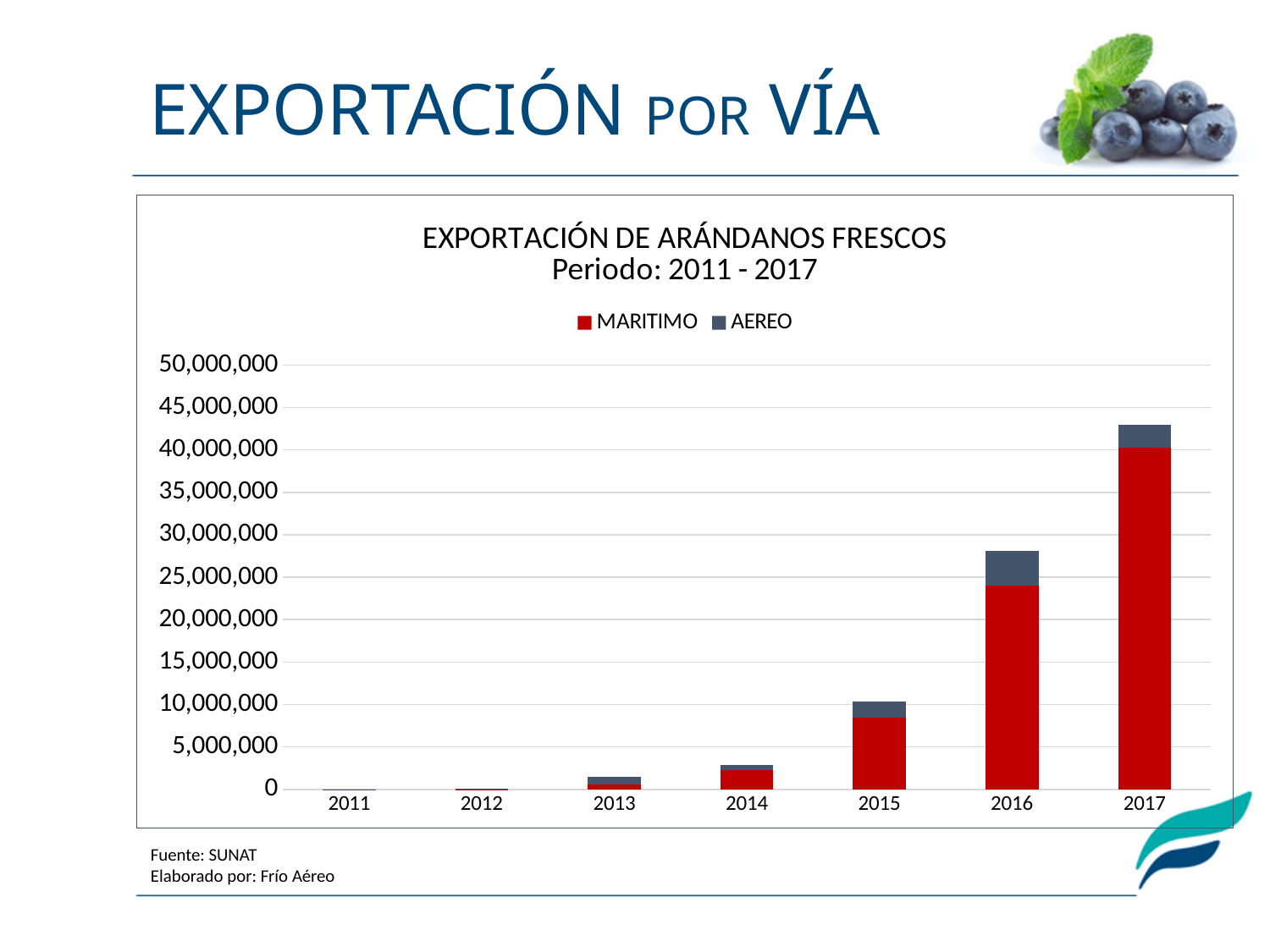
How many years are shown on the x axis of the chart? 7 In 2017, which series is larger, MARITIMO or AEREO? MARITIMO Which year has the lowest total export bar? 2011 Is the total stacked bar for 2017 greater or less than 40,000,000? greater Which colour represents the AEREO series in the chart? Gray Is the MARITIMO value for 2015 greater or less than 10,000,000? less Do the total export values rise or fall from 2011 to 2017? Rise Which year has the highest total export bar? 2017 Is the total stacked bar for 2016 greater or less than 30,000,000? less How many series does the chart's legend list? 2 What kind of chart is shown on the slide? Stacked bar chart